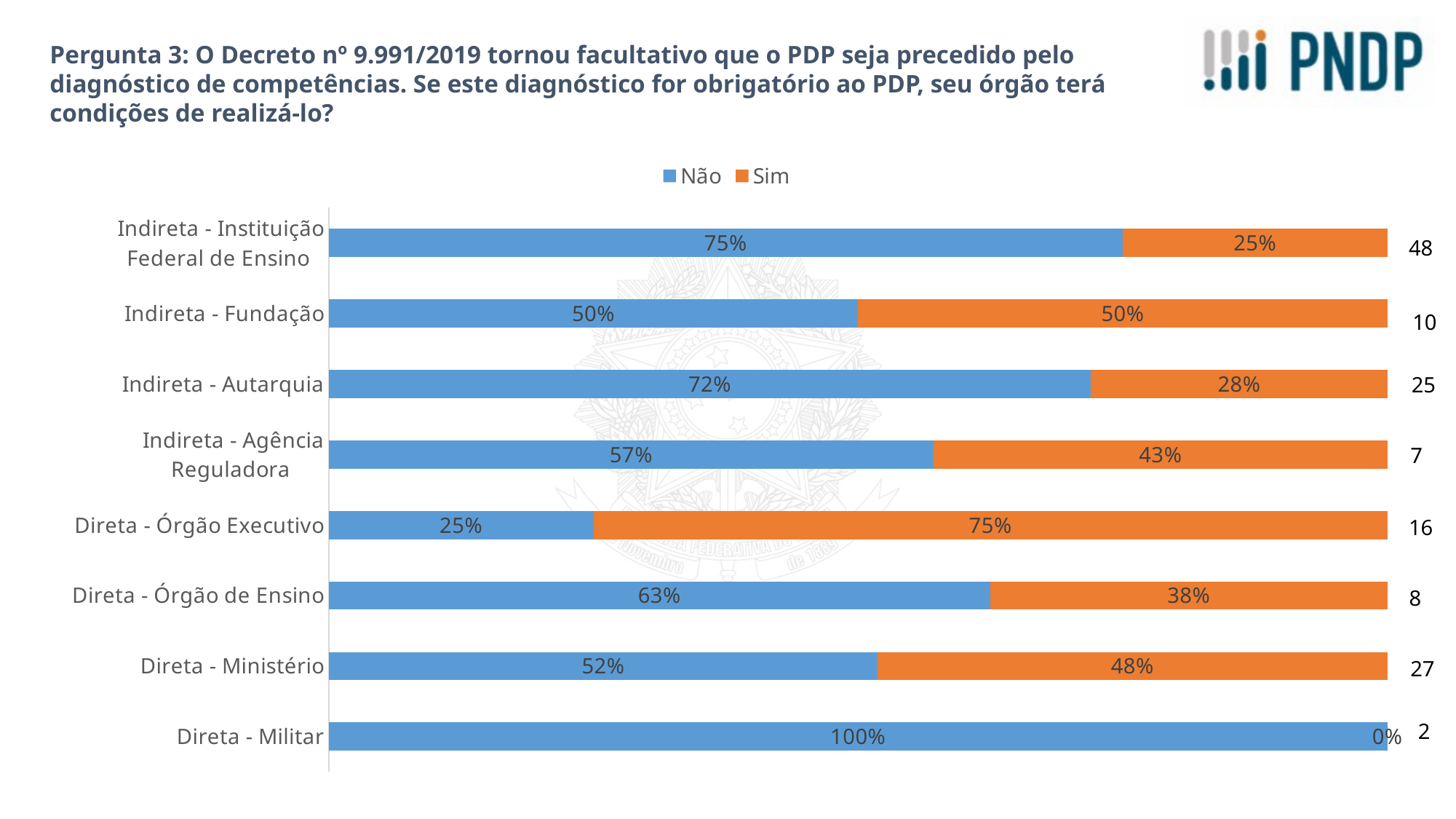
Which category has the highest "Não" value? Direta - Militar Which series is shown in orange in the legend? Sim What is the "Sim" value for Indireta - Agência Reguladora? 43% What is the "Sim" value for Direta - Órgão Executivo? 75% How many series does the legend list? 2 Which is larger for Direta - Órgão de Ensino, the "Não" value or the "Sim" value? Não What is the "Não" value for Indireta - Instituição Federal de Ensino? 75% Which category has the lowest "Sim" value? Direta - Militar What is the "Não" value for Direta - Ministério? 52% What kind of chart is shown on the slide? Stacked bar chart How many categories are shown on the chart? 8 What is the difference between the "Não" and "Sim" values for Indireta - Autarquia? 44%